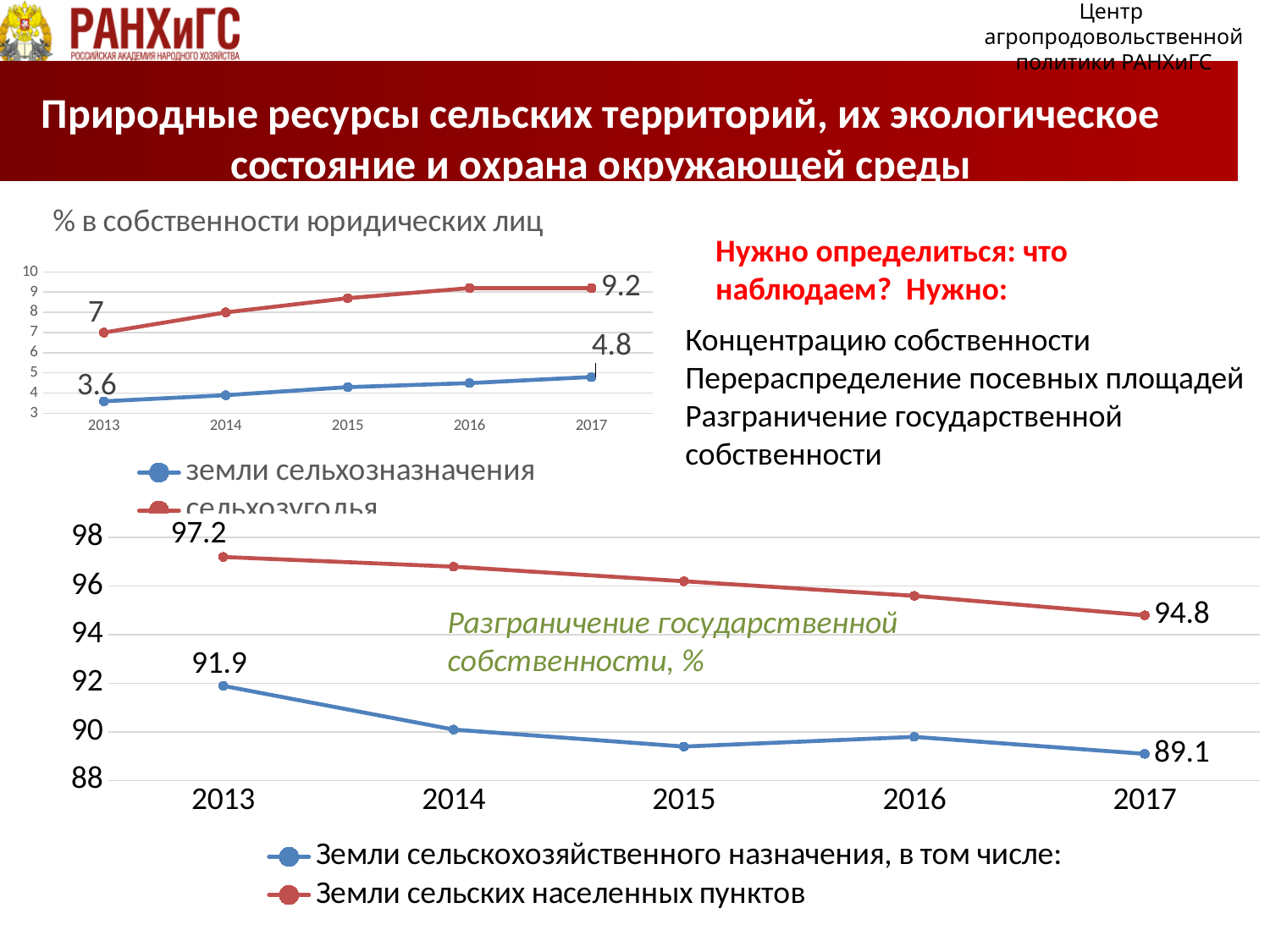
In the top chart '% в собственности юридических лиц', by how much did земли сельхозназначения change from 2013 to 2017? 1.2 In the bottom chart 'Разграничение государственной собственности, %', do the values for Земли сельских населенных пунктов rise or fall from 2013 to 2017? fall In the top chart '% в собственности юридических лиц', what is the value for сельхозугодья in 2017? 9.2 In the bottom chart 'Разграничение государственной собственности, %', what is the value for Земли сельскохозяйственного назначения in 2017? 89.1 What type of chart is the bottom chart 'Разграничение государственной собственности, %'? line chart In the top chart '% в собственности юридических лиц', what is the value for сельхозугодья in 2013? 7 In the bottom chart 'Разграничение государственной собственности, %', what is the value for Земли сельских населенных пунктов in 2013? 97.2 In the bottom chart 'Разграничение государственной собственности, %', what is the difference between Земли сельских населенных пунктов and Земли сельскохозяйственного назначения in 2017? 5.7 How many years are shown on the x axis of the bottom chart 'Разграничение государственной собственности, %'? 5 In the top chart '% в собственности юридических лиц', do the values for сельхозугодья rise or fall from 2013 to 2017? rise In the top chart '% в собственности юридических лиц', what is the value for земли сельхозназначения in 2013? 3.6 In the top chart '% в собственности юридических лиц', is the value for земли сельхозназначения in 2015 greater or less than 5? less